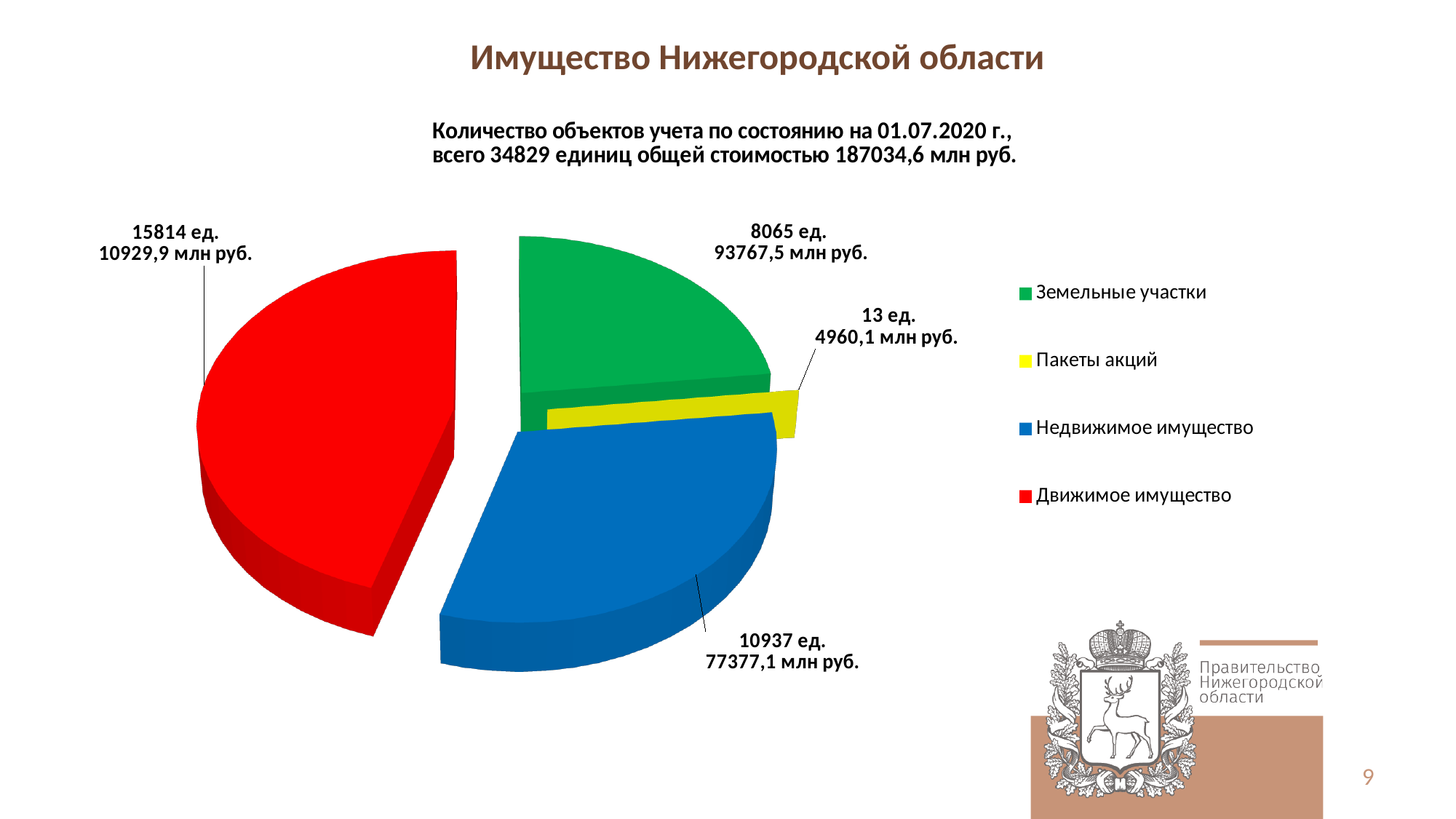
How many units (ед.) are shown for Пакеты акций? 13 ед. Which has a larger value in млн руб.: Земельные участки or Недвижимое имущество? Земельные участки Which category has the largest number of units (ед.)? Движимое имущество What colour represents Пакеты акций in the legend? Yellow What is the difference in units between Движимое имущество and Недвижимое имущество? 4877 ед. How many units (ед.) are shown for Движимое имущество? 15814 ед. How many categories does the pie chart have? 4 What kind of chart is shown on the slide? Pie chart Which category has the highest value in млн руб.? Земельные участки What is the value in млн руб. shown for Земельные участки? 93767,5 млн руб. Which category has the smallest number of units (ед.)? Пакеты акций What is the value in млн руб. shown for Недвижимое имущество? 77377,1 млн руб.